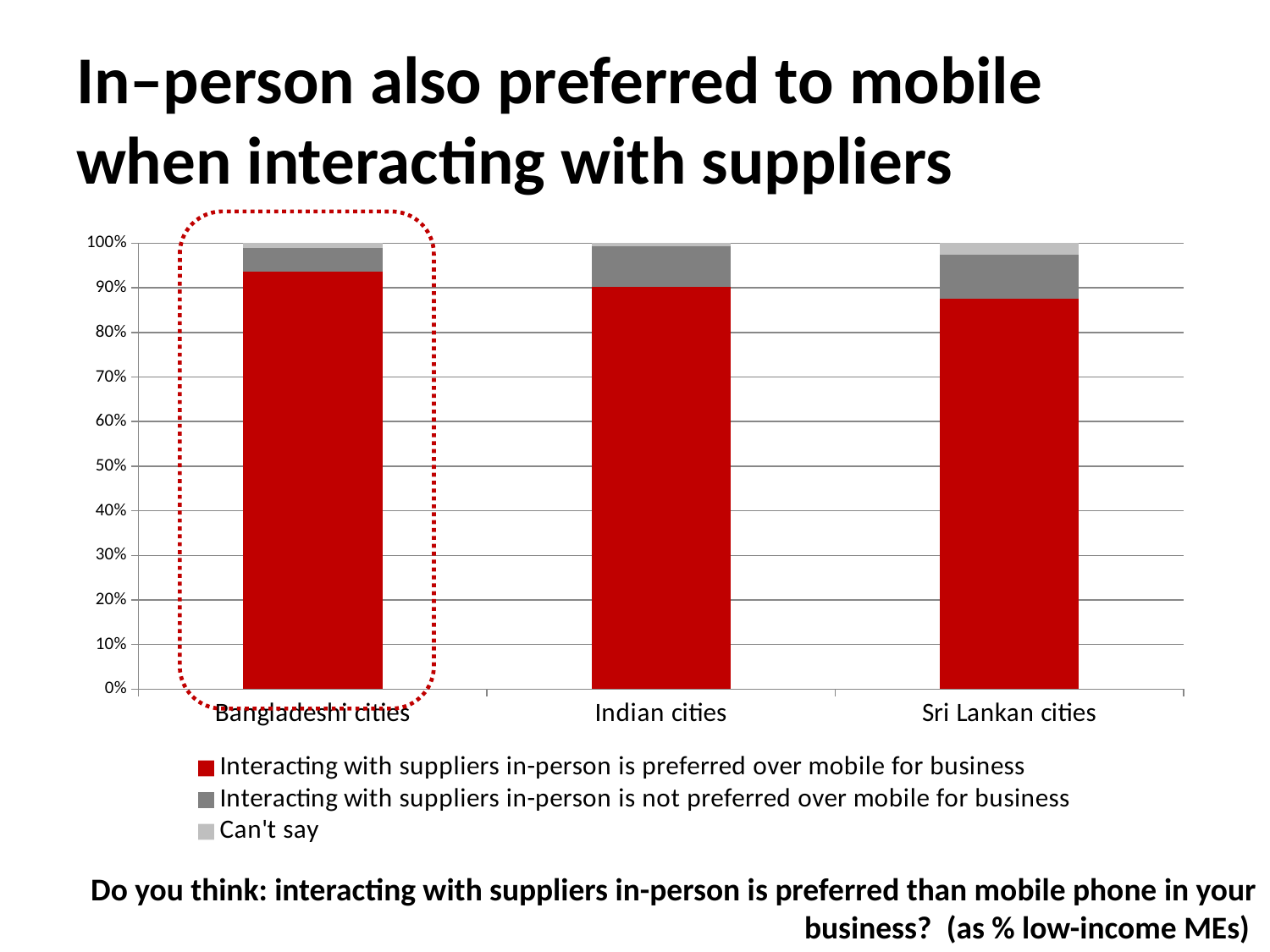
Is the 'preferred over mobile' share for Bangladeshi cities greater or less than 90%? greater Is the 'preferred over mobile' share for Sri Lankan cities greater or less than 90%? less Which city group has the highest share for 'Interacting with suppliers in-person is preferred over mobile for business'? Bangladeshi cities What colour represents 'Can't say' in the legend? Light grey Which is larger: the 'preferred over mobile' share for Bangladeshi cities or for Sri Lankan cities? Bangladeshi cities How many city groups (categories) are shown on the x axis? 3 Which city group is highlighted with a red dotted outline on the chart? Bangladeshi cities Is the 'preferred over mobile' share for Sri Lankan cities greater or less than 80%? greater Which city group has the smallest share for 'Interacting with suppliers in-person is not preferred over mobile for business'? Bangladeshi cities How many series does the legend list? 3 What kind of chart is shown on the slide? Stacked bar chart Which city group has the lowest share for 'Interacting with suppliers in-person is preferred over mobile for business'? Sri Lankan cities